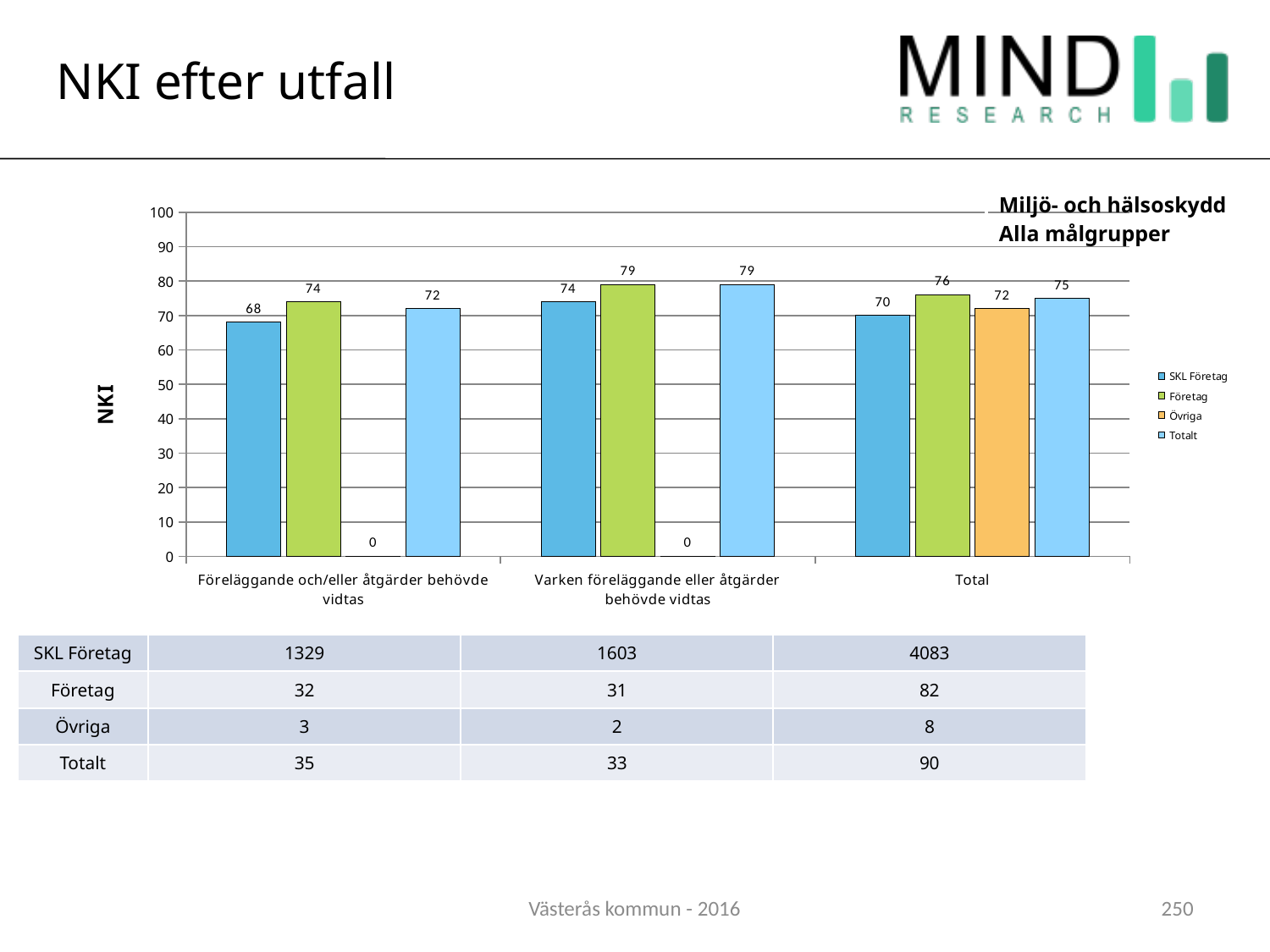
Which series has the lowest value in the 'Föreläggande och/eller åtgärder behövde vidtas' category? Övriga Which series has the highest value in the 'Total' category? Företag What is the value for SKL Företag in the category 'Föreläggande och/eller åtgärder behövde vidtas'? 68 How many categories are shown on the x axis? 3 How many series does the legend list? 4 What is the value for Företag in the category 'Varken föreläggande eller åtgärder behövde vidtas'? 79 What type of chart is shown on the slide? bar chart What is the difference between the Företag value and the SKL Företag value in the 'Total' category? 6 Which is larger: the Totalt value for 'Föreläggande och/eller åtgärder behövde vidtas' or the Totalt value for 'Varken föreläggande eller åtgärder behövde vidtas'? Varken föreläggande eller åtgärder behövde vidtas What is the value for Totalt in the 'Total' category? 75 What is the label of the y axis? NKI What is the value for Övriga in the 'Total' category? 72